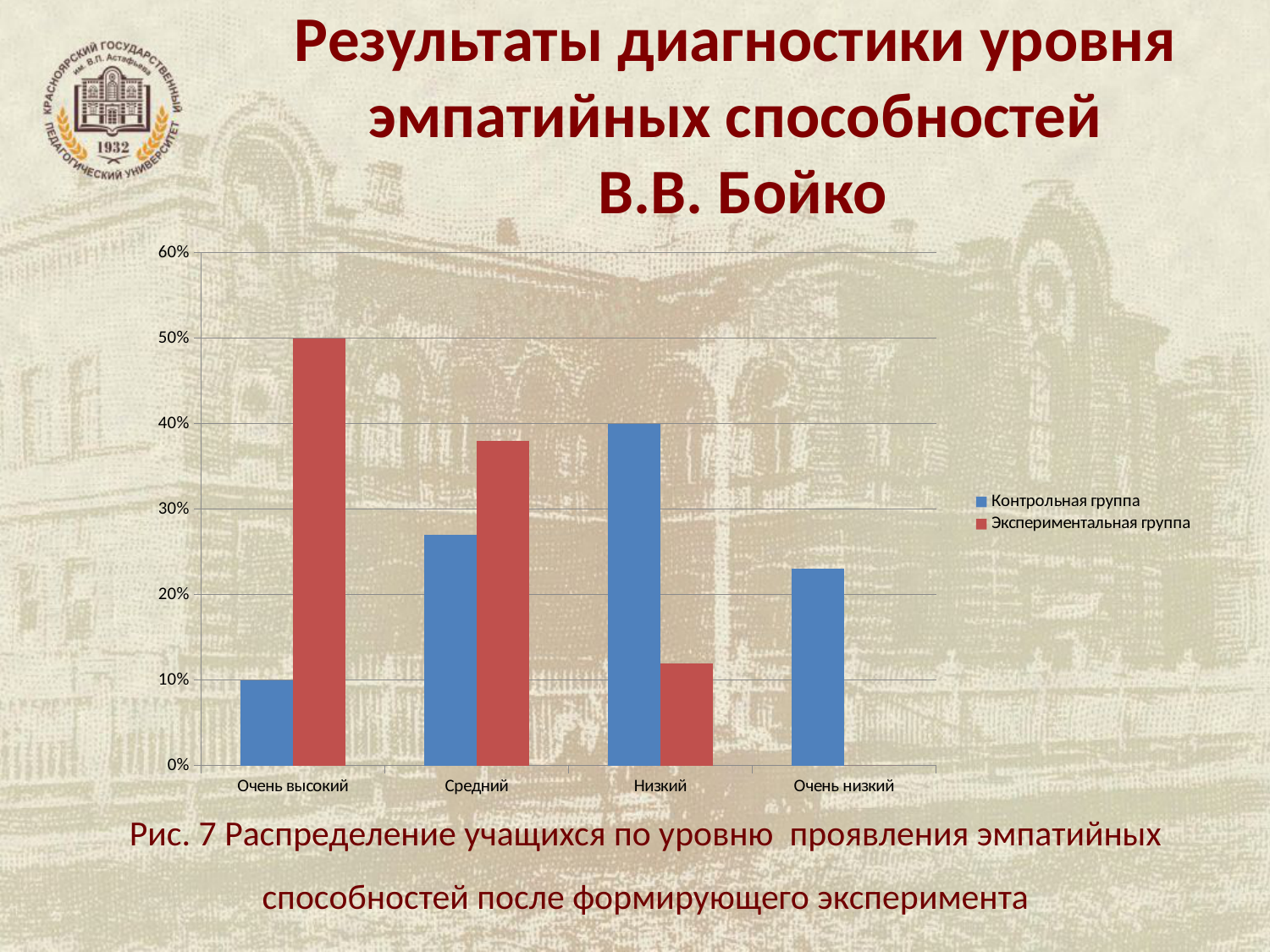
What is the value for Экспериментальная группа in the category Очень высокий? 50% What is the difference between the Экспериментальная группа and Контрольная группа values in the category Очень высокий? 40% In the category Средний, which group has the larger value? Экспериментальная группа How many series does the chart legend list? 2 What kind of chart is shown on the slide? Bar chart What is the value for Контрольная группа in the category Низкий? 40% In which category is the Контрольная группа bar the highest? Низкий How many categories are shown on the x axis of the chart? 4 What is the value for Контрольная группа in the category Очень высокий? 10% In which category is the Экспериментальная группа bar the highest? Очень высокий Is the value for Контрольная группа in the category Средний greater or less than 30%? less In which category is the Контрольная группа bar the lowest? Очень высокий